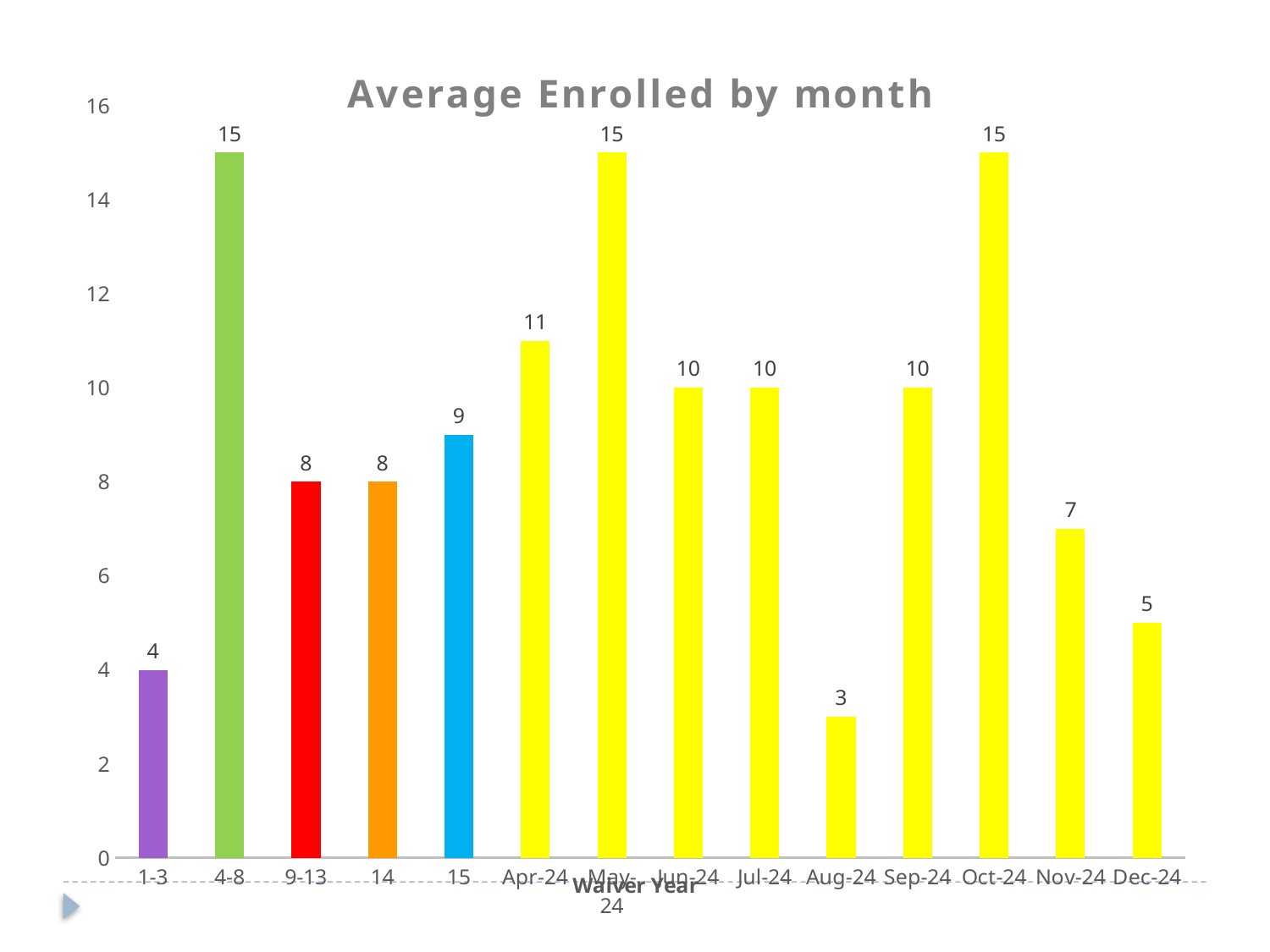
What is the value for Aug-24? 3 What is the title of the chart? Average Enrolled by month What is the value for Apr-24? 11 Which is larger, the value for 15 or the value for 14? 15 Which category has the lowest value? Aug-24 What is the value for the 1-3 category? 4 What is the difference between the values for May-24 and Dec-24? 10 Which is larger, the value for Oct-24 or the value for Sep-24? Oct-24 What kind of chart is shown on the slide? Bar chart What is the difference between the values for 4-8 and 9-13? 7 What is the value for Nov-24? 7 How many categories are shown on the x axis? 14